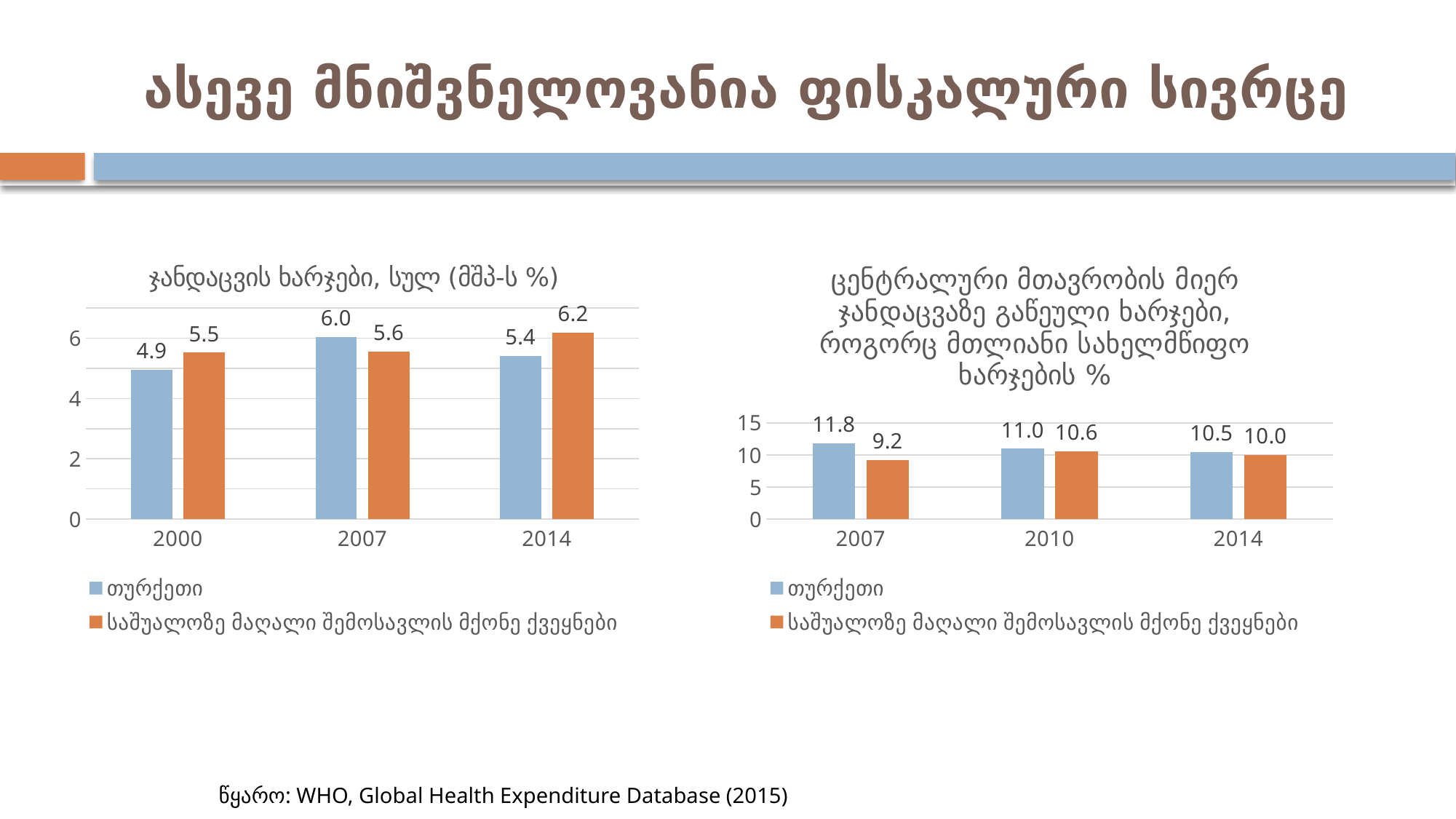
In the left chart, what is the value for საშუალოზე მაღალი შემოსავლის მქონე ქვეყნები in 2014? 6.2 In the right chart, what is the value for თურქეთი in 2007? 11.8 In the right chart, does the value for თურქეთი rise or fall from 2007 to 2014? fall In the left chart, what is the difference between the two series in 2014? 0.8 In the right chart, in which year is the value for საშუალოზე მაღალი შემოსავლის მქონე ქვეყნები lowest? 2007 In the left chart, what is the value for თურქეთი in 2000? 4.9 In the left chart, in which year is the value for თურქეთი highest? 2007 In the left chart, how many years are shown on the x axis? 3 What type of chart is the left chart? bar chart How many series does the legend of the right chart list? 2 In the left chart, which series has the larger value in 2007? თურქეთი In the right chart, what is the value for საშუალოზე მაღალი შემოსავლის მქონე ქვეყნები in 2010? 10.6